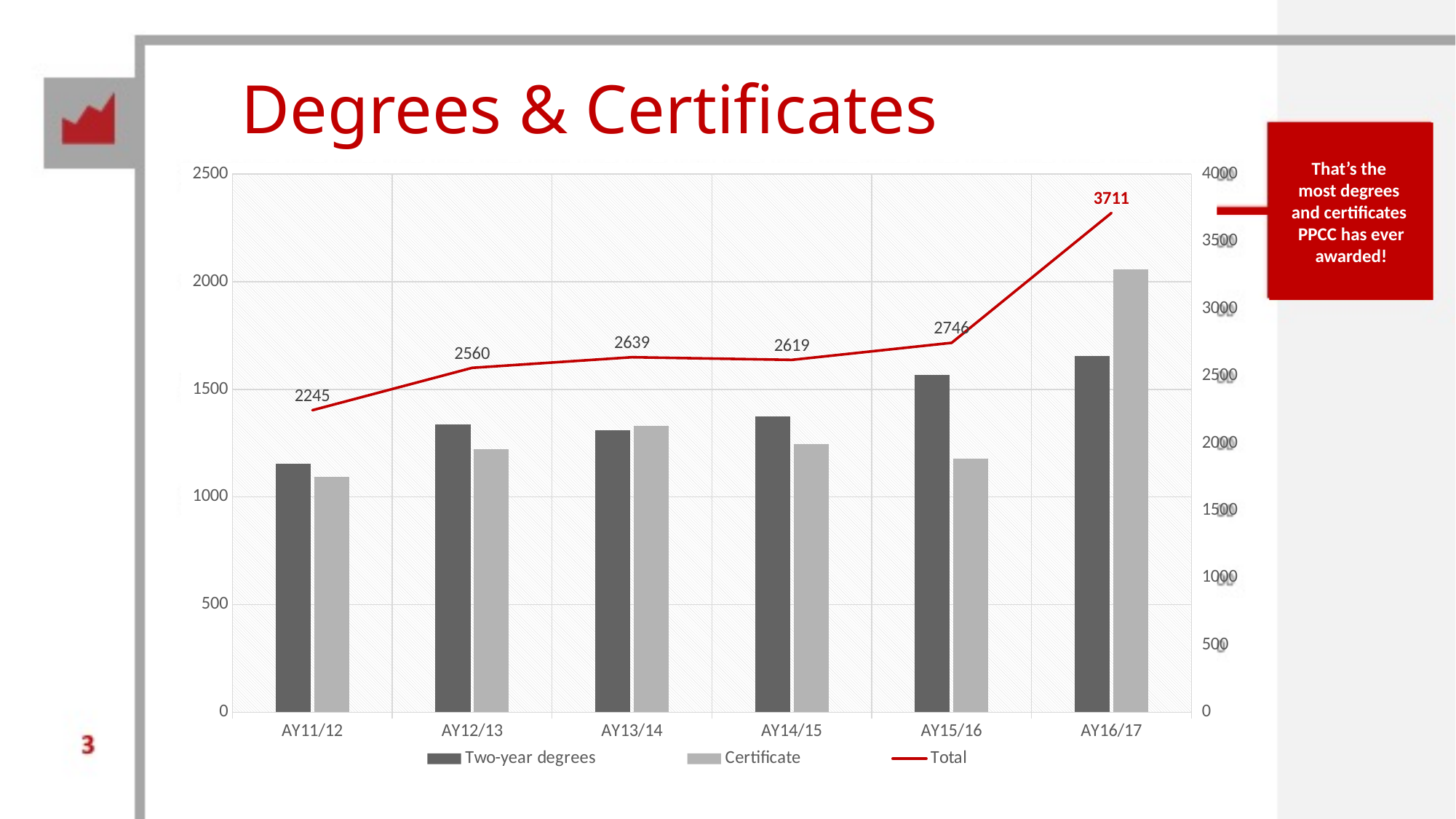
Which academic year has the highest Total? AY16/17 What is the difference between the Total for AY16/17 and the Total for AY15/16? 965 What is the Total value for AY14/15? 2619 What is the Total value for AY11/12? 2245 Is the value for Certificate in AY16/17 greater or less than 1500? greater What is the Total value for AY16/17? 3711 How many academic years are shown on the x axis? 6 Which is larger, the Total for AY13/14 or the Total for AY14/15? AY13/14 Which academic year has the lowest Total? AY11/12 Is the value for Two-year degrees in AY11/12 greater or less than 1500? less How many series does the legend list? 3 Does the Total line generally rise or fall from AY11/12 to AY16/17? rise